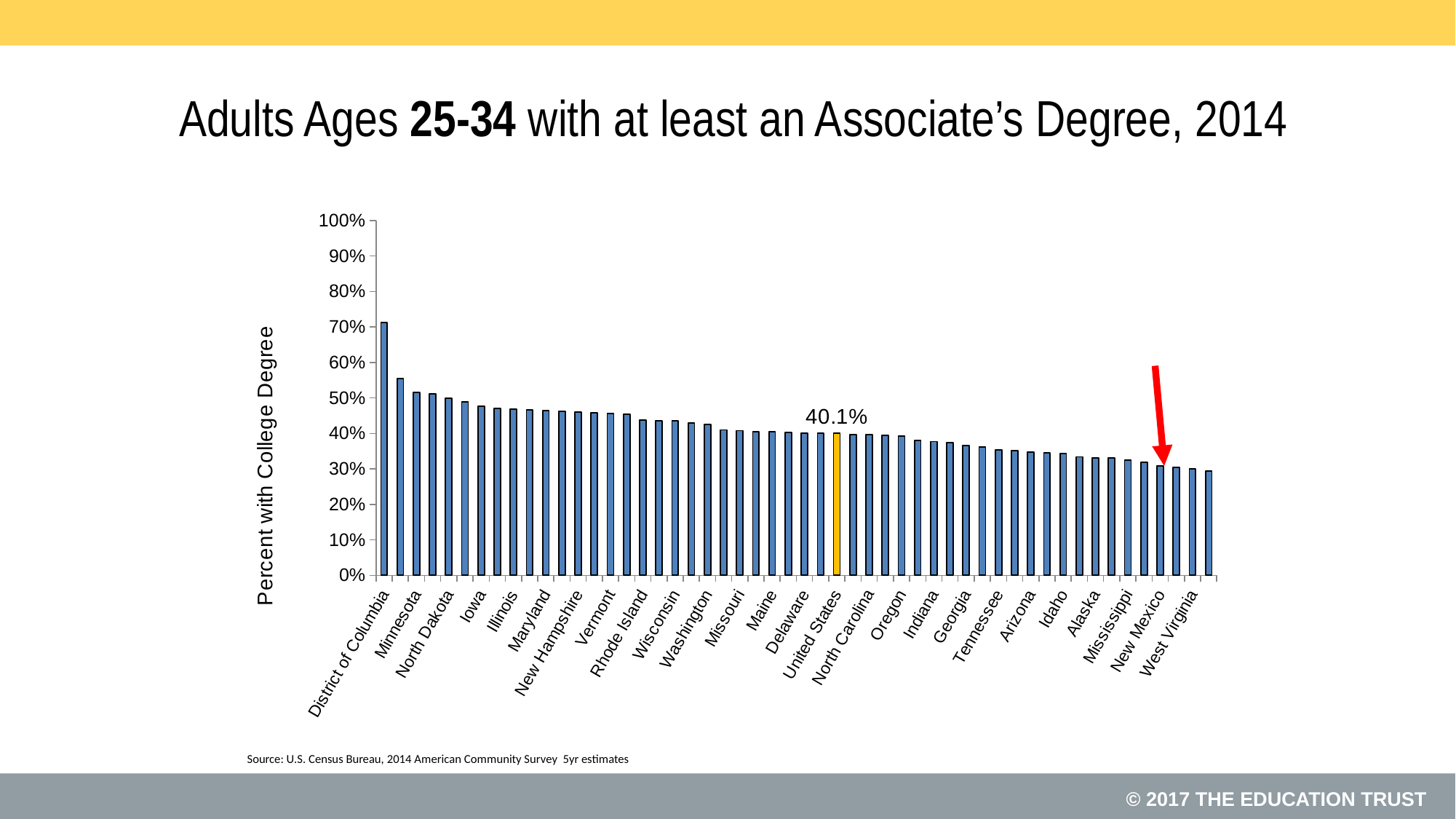
Which category has the highest value? District of Columbia Is the value for Mississippi greater or less than 40%? less What is the value shown for United States? 40.1% What kind of chart is shown on the slide? bar chart Is the value for District of Columbia greater or less than 60%? greater Is the value for Iowa greater or less than 40%? greater Which is larger, the value for District of Columbia or the value for Minnesota? District of Columbia What is the title of the y axis? Percent with College Degree Which is larger, the value for North Dakota or the value for Georgia? North Dakota Do the values rise or fall moving from left to right along the x axis? fall Which bar is highlighted in a different colour from the others? United States